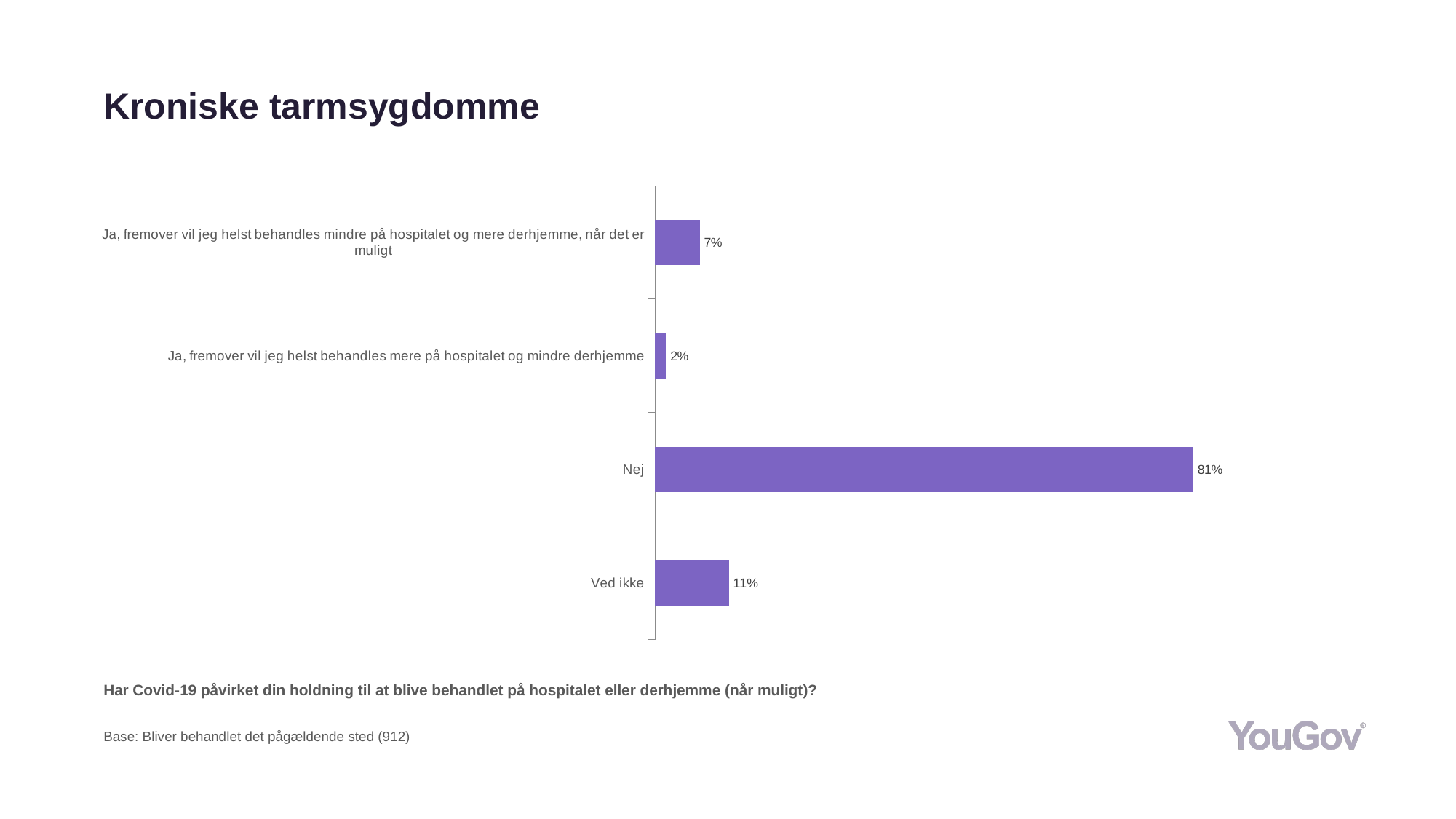
Which is larger: the value for "Ved ikke" or the value for "Ja, fremover vil jeg helst behandles mindre på hospitalet og mere derhjemme, når det er muligt"? Ved ikke What is the value for "Ved ikke"? 11% What is the difference between the values for "Nej" and "Ved ikke"? 70 percentage points What type of chart is shown on the slide? Bar chart How many categories are shown in the chart? 4 What is the base size stated below the chart? 912 What is the value for "Ja, fremover vil jeg helst behandles mindre på hospitalet og mere derhjemme, når det er muligt"? 7% Which category has the lowest value? Ja, fremover vil jeg helst behandles mere på hospitalet og mindre derhjemme What percentage chose "Ja, fremover vil jeg helst behandles mere på hospitalet og mindre derhjemme"? 2% Which category has the highest value? Nej What is the difference between the two "Ja" answers (7% and 2%)? 5 percentage points What percentage of respondents answered "Nej"? 81%